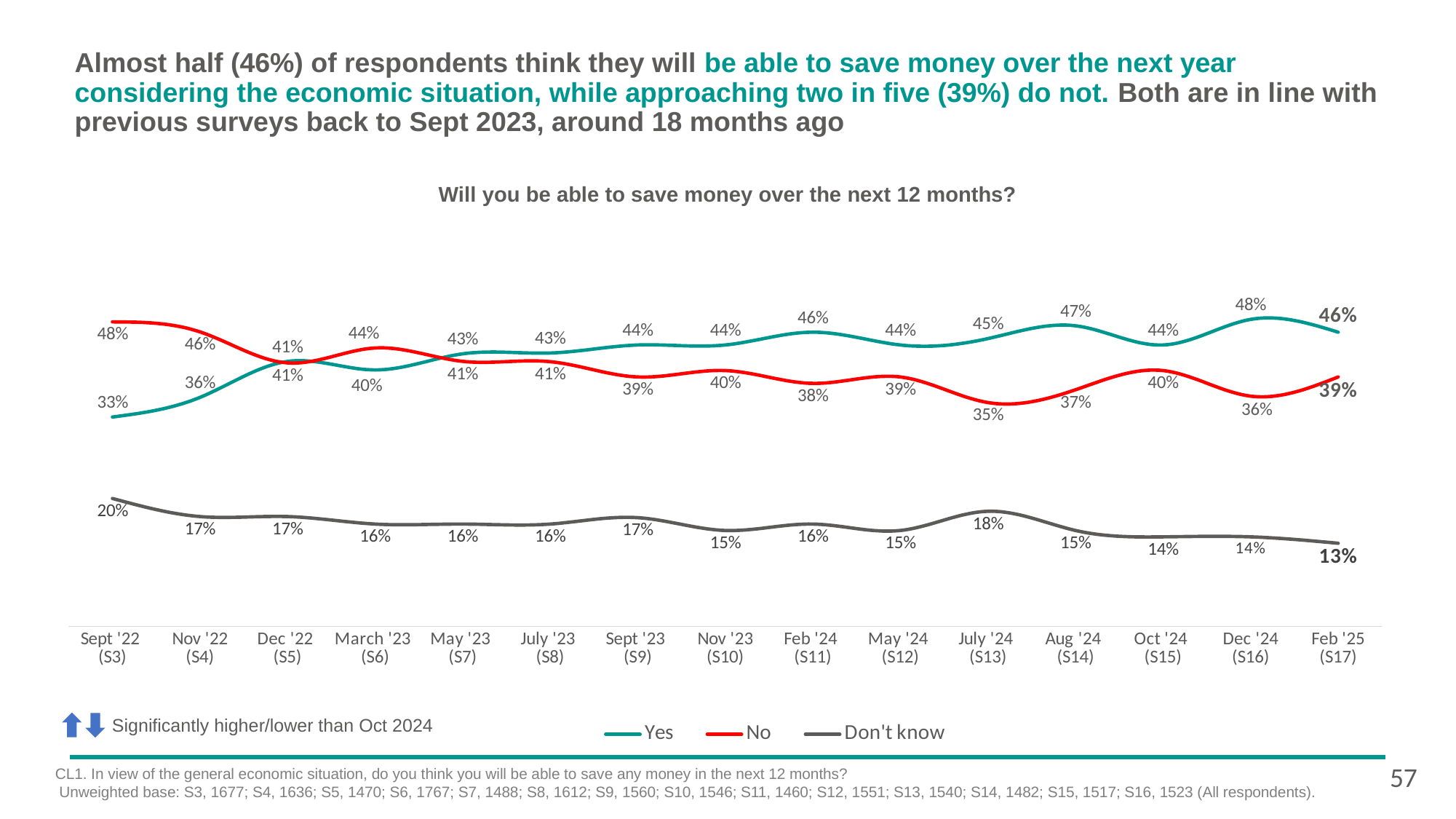
What percentage of respondents answered 'Yes' in Feb '25 (S17)? 46% What was the 'Don't know' value in Sept '22 (S3)? 20% What was the 'No' value in July '24 (S13)? 35% What type of chart is shown? Line chart How many series does the legend list? 3 In which survey wave was the 'Yes' value highest? Dec '24 (S16) In which survey wave was the 'Yes' value lowest? Sept '22 (S3) What is the difference between the 'Yes' and 'No' values in Feb '25 (S17)? 7 percentage points In Sept '22 (S3), which was larger: 'Yes' or 'No'? No Does the 'Don't know' line generally rise or fall from Sept '22 to Feb '25? Fall In which survey wave was the 'Don't know' value lowest? Feb '25 (S17) How many survey waves are shown on the x axis? 15